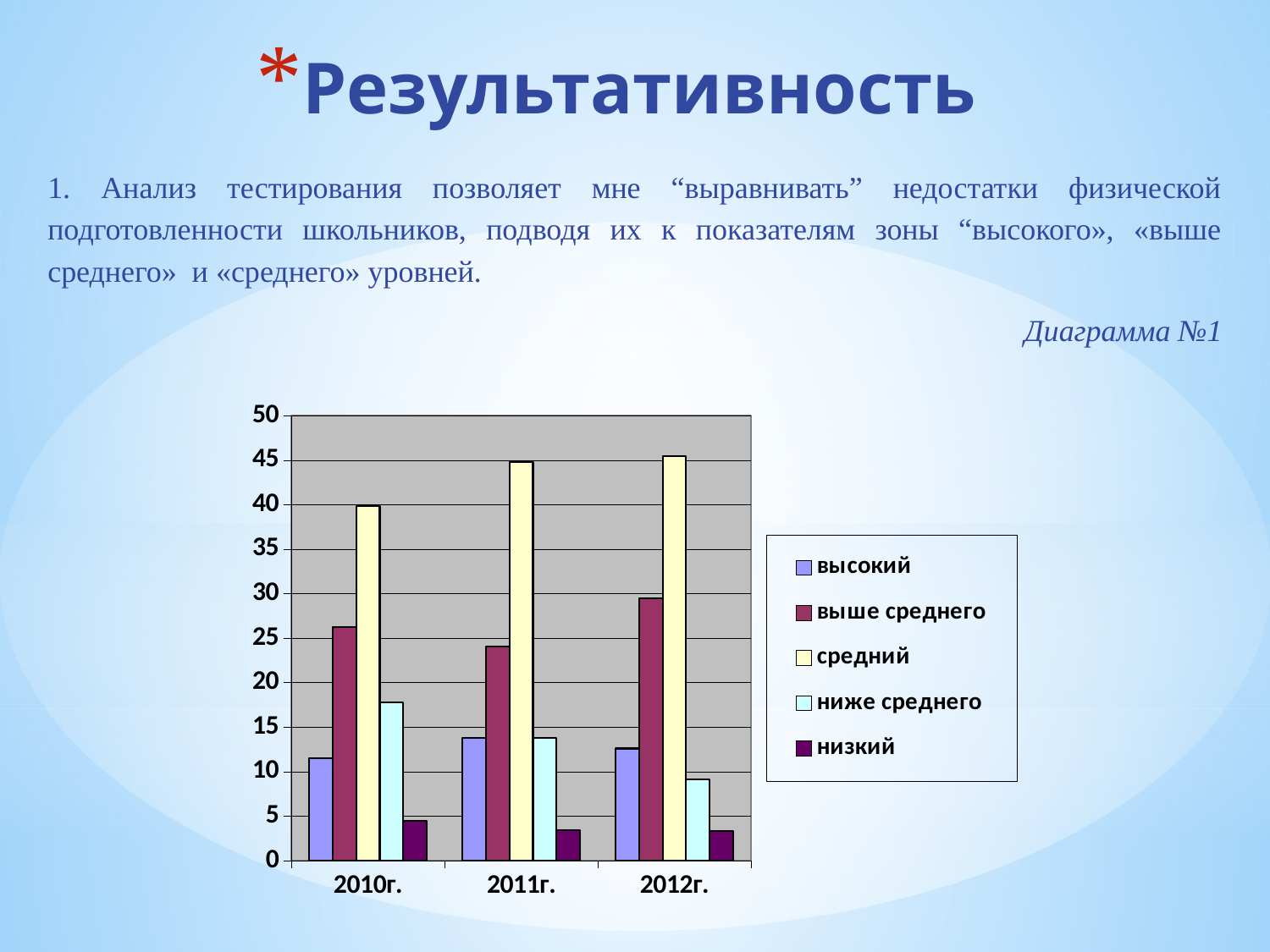
Is the value for ниже среднего in 2012г. greater or less than 10? less Is the value for выше среднего in 2011г. greater or less than 20? greater Which is larger: выше среднего in 2010г. or выше среднего in 2012г.? 2012г. Which series has the lowest value in 2012г.? низкий What kind of chart is shown on the slide? bar chart How many year categories are shown on the x axis? 3 What label is given to the chart above it on the slide? Диаграмма №1 Which series has the highest value in 2010г.? средний Is the value for средний in 2010г. greater or less than 35? greater How many series does the legend list? 5 Does the value for ниже среднего rise or fall from 2010г. to 2012г.? fall